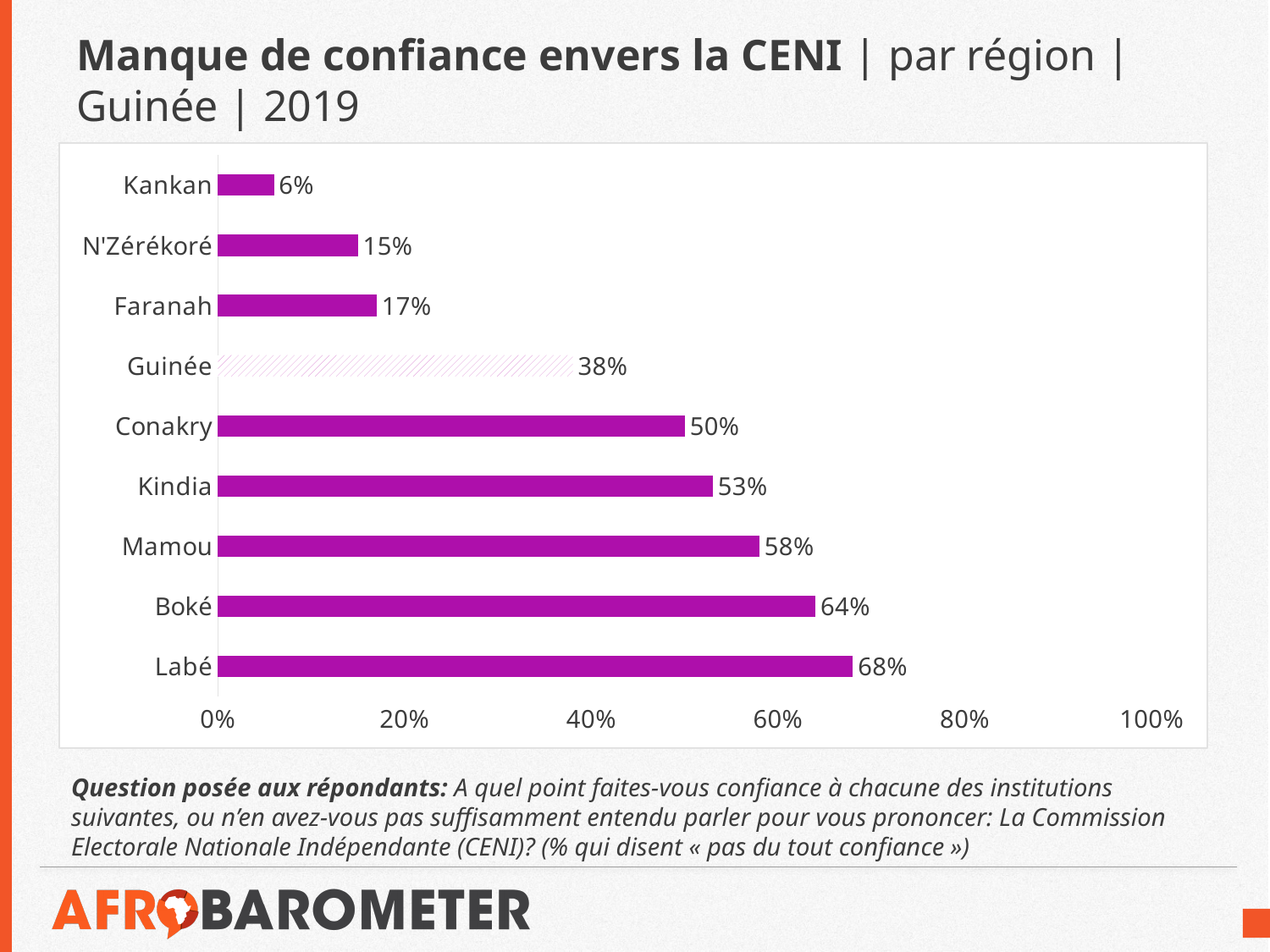
Which category has the lowest value? Kankan Which bar is drawn with a hatched pattern rather than solid fill? Guinée Which region has the highest value? Labé What is the value for Kankan? 6% What is the difference between the values for Boké and Conakry? 14% What kind of chart is shown on the slide? bar chart What is the value for Guinée? 38% Which has a larger value, Mamou or Kindia? Mamou What is the value for N'Zérékoré? 15% What is the value for Labé? 68% How many categories are shown on the chart? 9 Is the value for Faranah greater or less than 20%? less